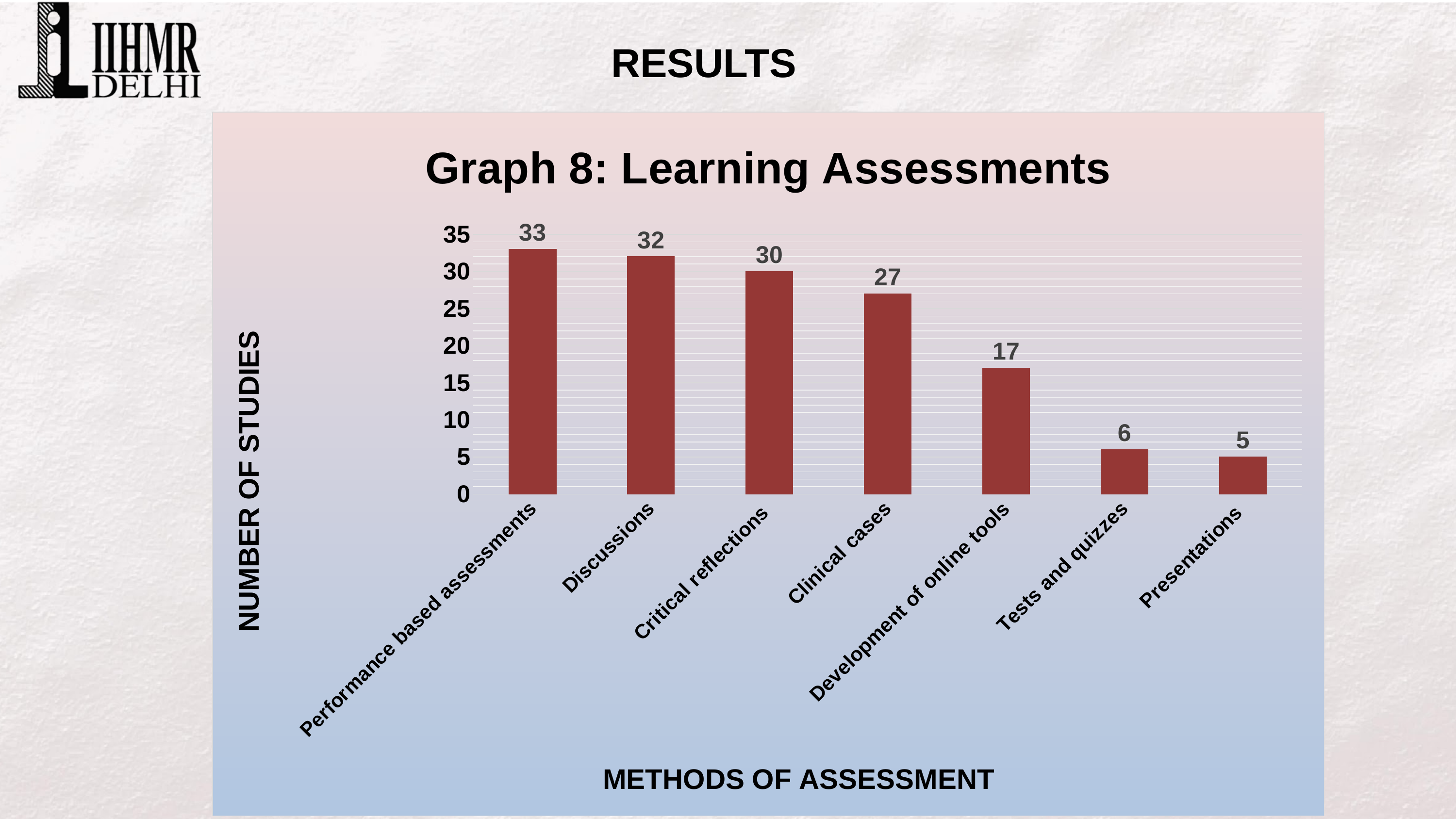
Which has more studies, Clinical cases or Development of online tools? Clinical cases Which method of assessment has the highest number of studies? Performance based assessments What is the difference in number of studies between Performance based assessments and Tests and quizzes? 27 Is the value for Critical reflections greater or less than 25? greater What is the number of studies for Presentations? 5 What is the title of the chart? Graph 8: Learning Assessments What is the number of studies for Development of online tools? 17 What is the number of studies for Discussions? 32 How many methods of assessment are shown on the chart? 7 What kind of chart is shown on the slide? Bar chart Which method of assessment has the lowest number of studies? Presentations What is the difference in number of studies between Critical reflections and Clinical cases? 3